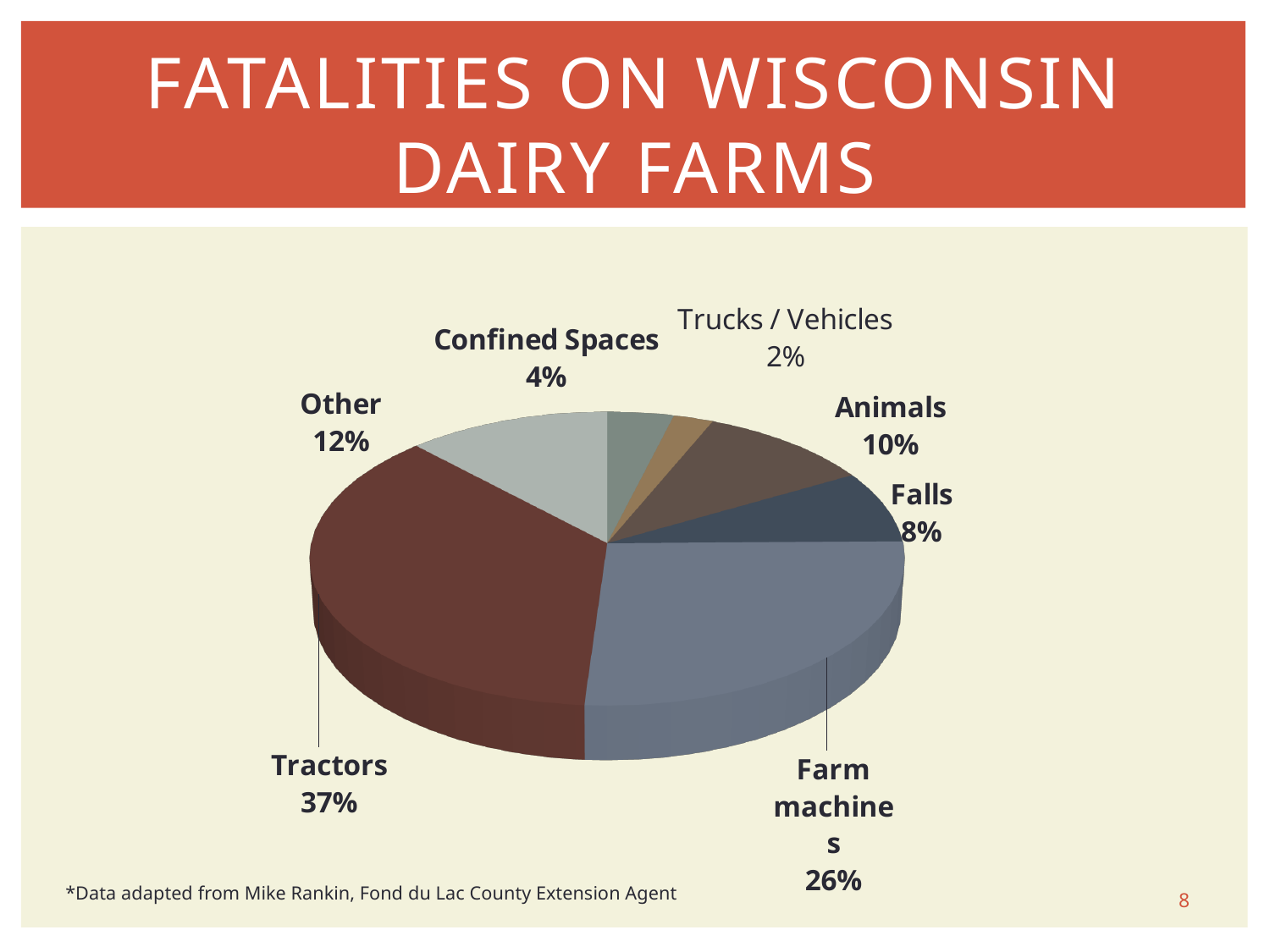
How many categories are shown in the pie chart? 7 What share of fatalities is attributed to Farm machines? 26% What share of fatalities is attributed to Tractors? 37% What is the title of the slide containing the chart? Fatalities on Wisconsin Dairy Farms Which category accounts for the smallest share of fatalities? Trucks / Vehicles Which category accounts for the largest share of fatalities? Tractors What share of fatalities is attributed to Trucks / Vehicles? 2% What share of fatalities is attributed to Animals? 10% What is the difference in percentage points between Tractors and Farm machines? 11 Which is larger, the share for Other or the share for Falls? Other What kind of chart is shown on the slide? Pie chart What is the combined share of Confined Spaces and Falls? 12%